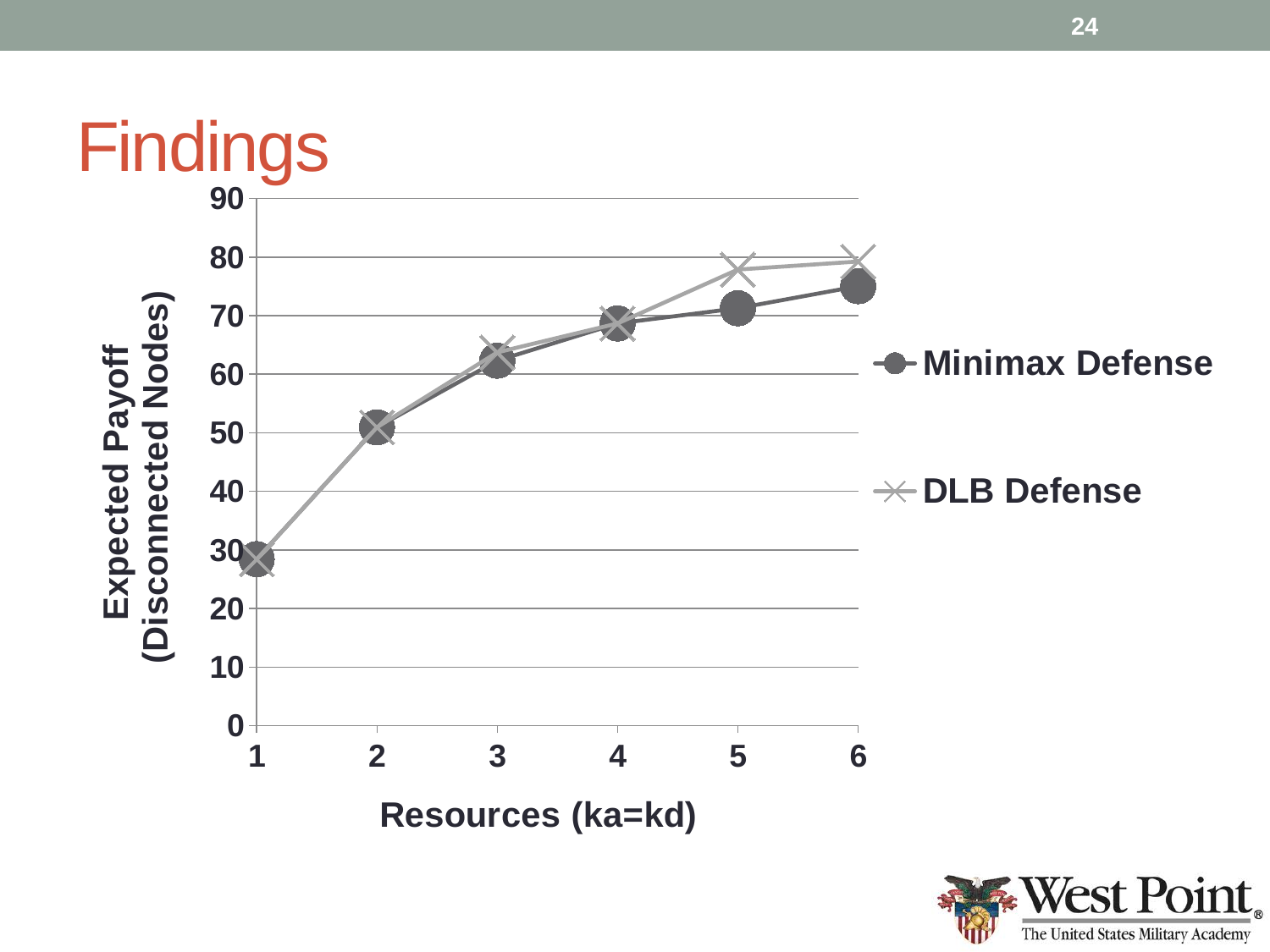
Do the Minimax Defense values rise or fall as Resources increase from 1 to 6? rise Is the DLB Defense value at Resources = 3 greater or less than 70? less What kind of chart is shown on the slide? line chart How many resource levels are plotted along the x axis? 6 Is the Minimax Defense value at Resources = 1 greater or less than 40? less At Resources = 5, which series has the higher expected payoff, Minimax Defense or DLB Defense? DLB Defense At which Resources value is the Minimax Defense expected payoff lowest? 1 What is the label of the y axis? Expected Payoff (Disconnected Nodes) How many series does the legend list? 2 At which Resources value is the DLB Defense expected payoff highest? 6 What is the label of the x axis? Resources (ka=kd) Is the Minimax Defense value at Resources = 6 greater or less than 70? greater